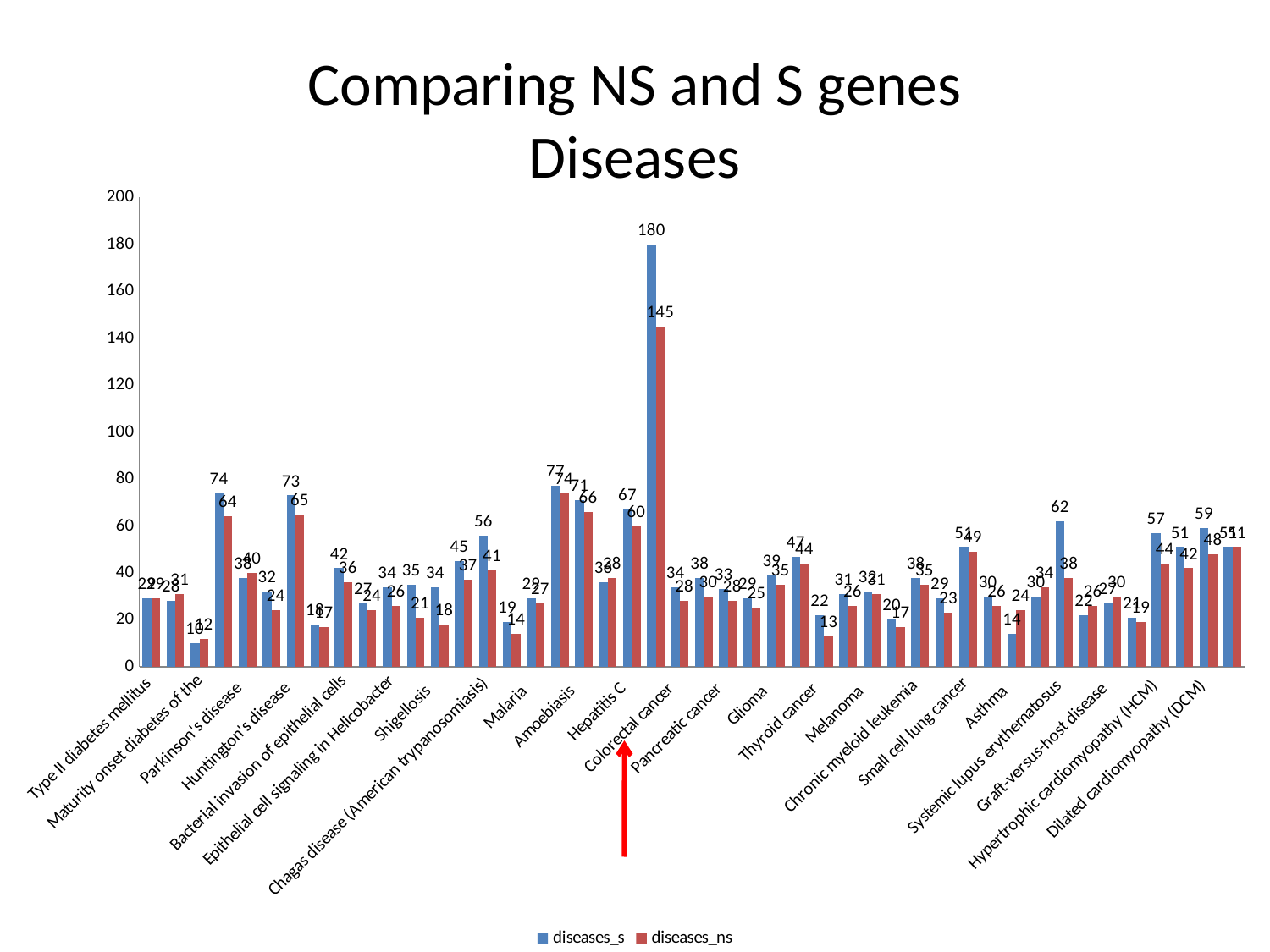
What is the difference between the tallest diseases_s bar (180) and the tallest diseases_ns bar (145)? 35 How many series does the legend list? 2 Which series does the tallest bar on the chart belong to? diseases_s What is the maximum value on the vertical axis? 200 Is the tallest diseases_ns bar greater or less than 140? greater What is the highest value shown on the chart? 180 Which series is drawn in blue, diseases_s or diseases_ns? diseases_s What are the two series named in the legend? diseases_s and diseases_ns What is the highest value shown for the diseases_ns series? 145 What type of chart is shown on the slide? bar chart Is the tallest bar on the chart greater or less than 160? greater